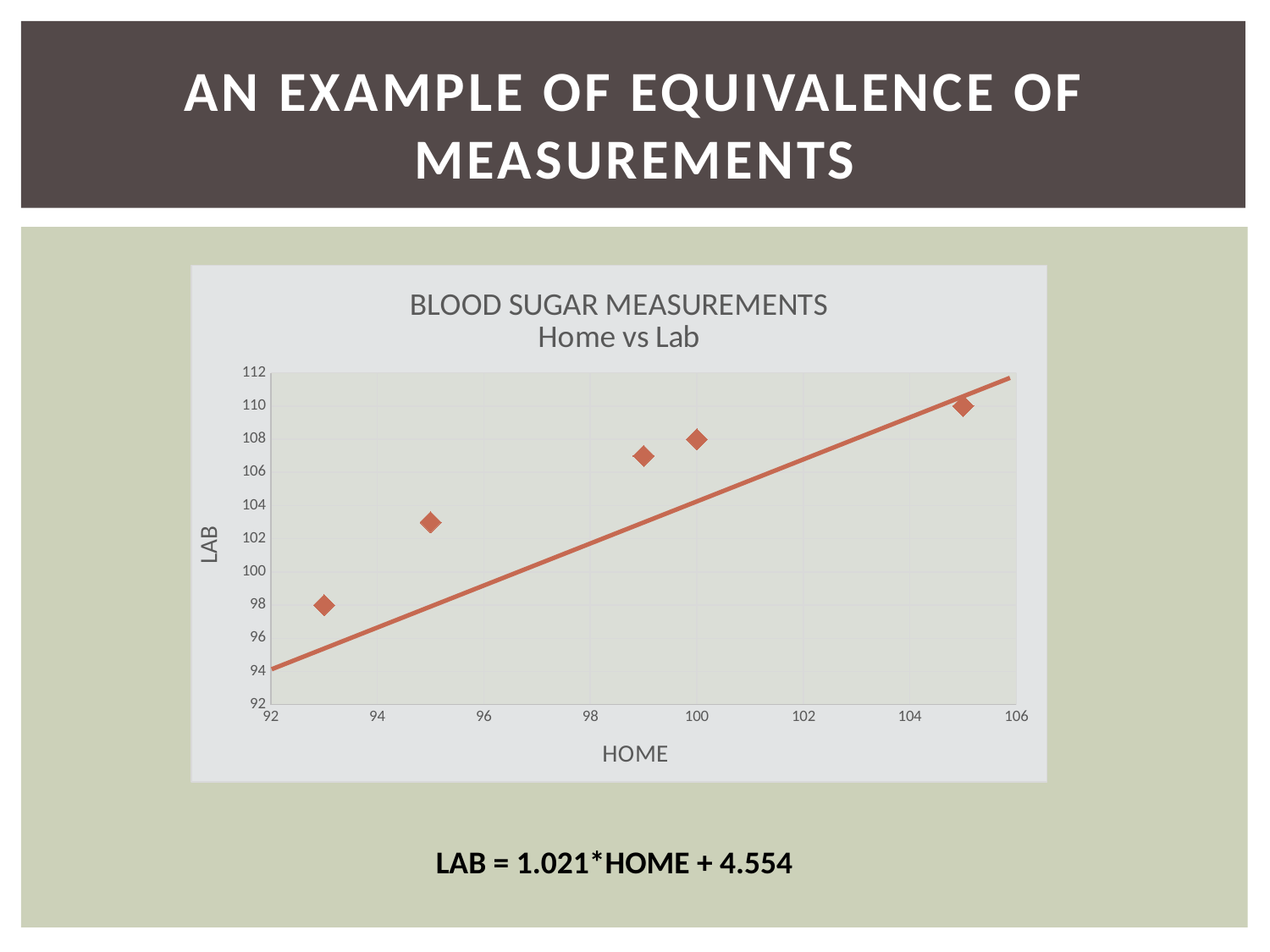
Is the LAB value for the point with the highest HOME value greater or less than 108? greater What kind of chart is shown on the slide? scatter chart What is the title of the chart? BLOOD SUGAR MEASUREMENTS Home vs Lab Is the LAB value for the point at HOME = 95 greater or less than 104? less What label is on the vertical axis of the chart? LAB Which has the larger LAB value: the point at HOME = 95 or the point at HOME = 100? the point at HOME = 100 Is the LAB value for the point at HOME = 100 greater or less than 106? greater Do the LAB values rise or fall as the HOME values increase along the x axis? rise How many data points are plotted in the Blood Sugar Measurements chart? 5